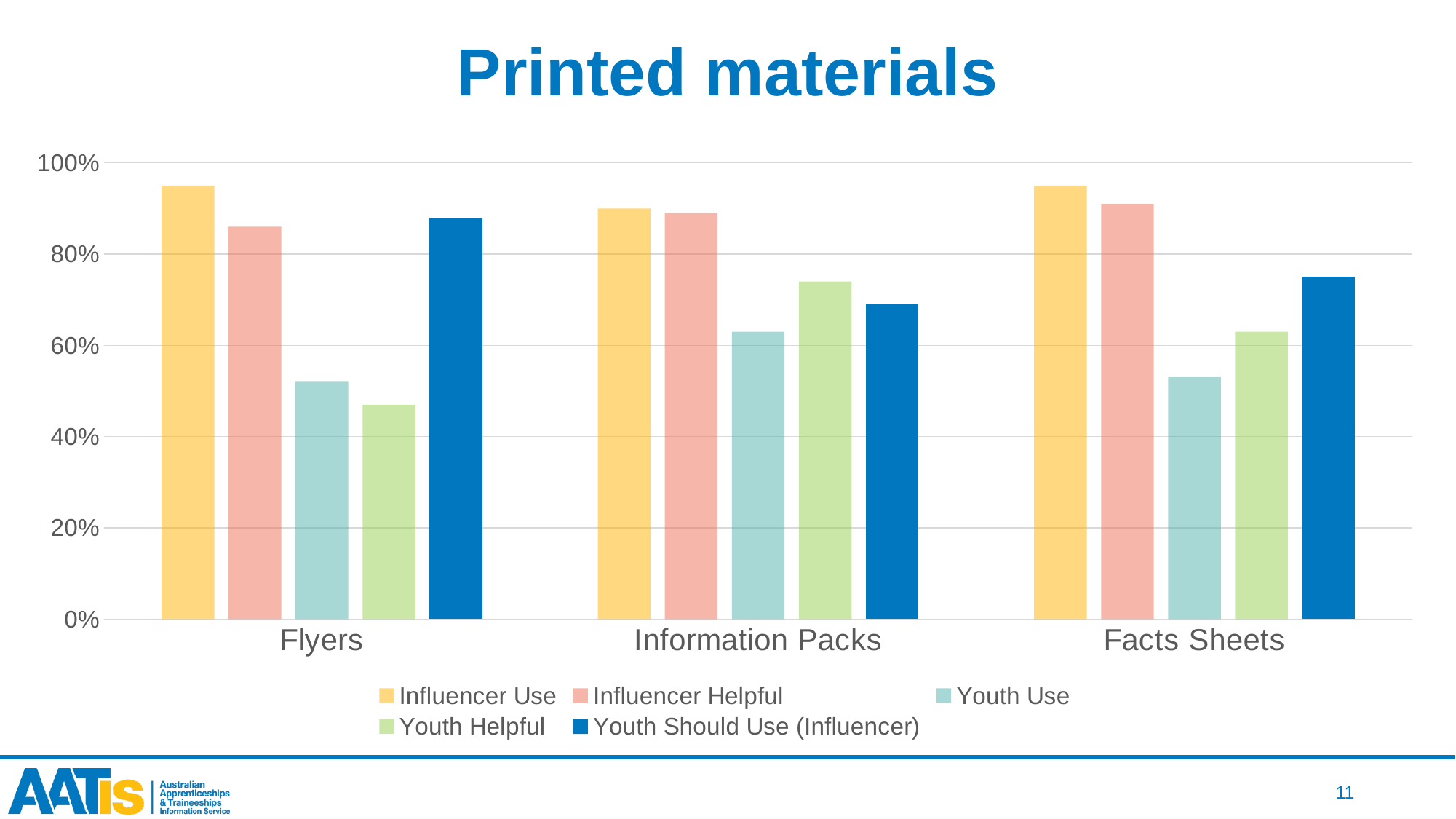
For Information Packs, which is larger: Youth Helpful or Youth Use? Youth Helpful How many categories are shown on the x axis? 3 For Flyers, which series has the highest value? Influencer Use What is the title of the chart? Printed materials For Youth Should Use (Influencer), which category has the highest value? Flyers What kind of chart is shown on the slide? bar chart For Flyers, which series has the lowest value? Youth Helpful Is the Youth Should Use (Influencer) value for Flyers greater or less than 80%? greater Which series is shown in dark blue in the legend? Youth Should Use (Influencer) For Facts Sheets, which series has the lowest value? Youth Use Is the Youth Helpful value for Flyers greater or less than 60%? less How many series does the legend list? 5